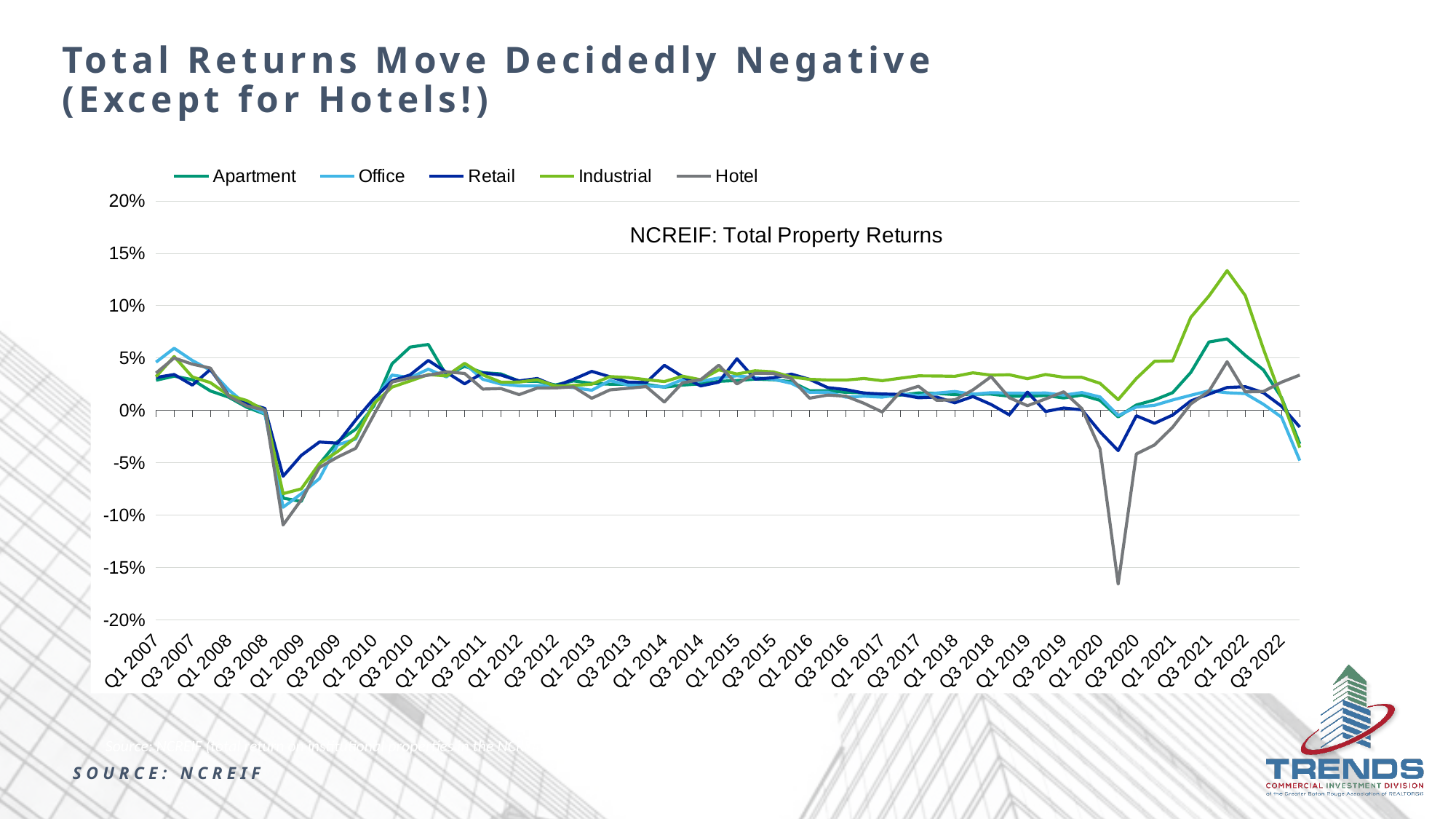
Is the value for Industrial at Q1 2022 greater or less than 10%? greater How many series does the legend list? 5 What is the title printed inside the chart area? NCREIF: Total Property Returns Which series has the lowest value at Q3 2020? Hotel Which series reaches the lowest value anywhere on the chart? Hotel What kind of chart is shown on the slide? Line chart Which series is plotted with a grey line? Hotel Is the value for Hotel at Q1 2009 greater or less than -10%? greater Does the Industrial line rise or fall between Q3 2020 and Q1 2022? Rise Is the value for Hotel at Q3 2020 greater or less than -15%? greater Which series reaches the highest value anywhere on the chart? Industrial At Q1 2022, which series has the higher value, Industrial or Hotel? Industrial